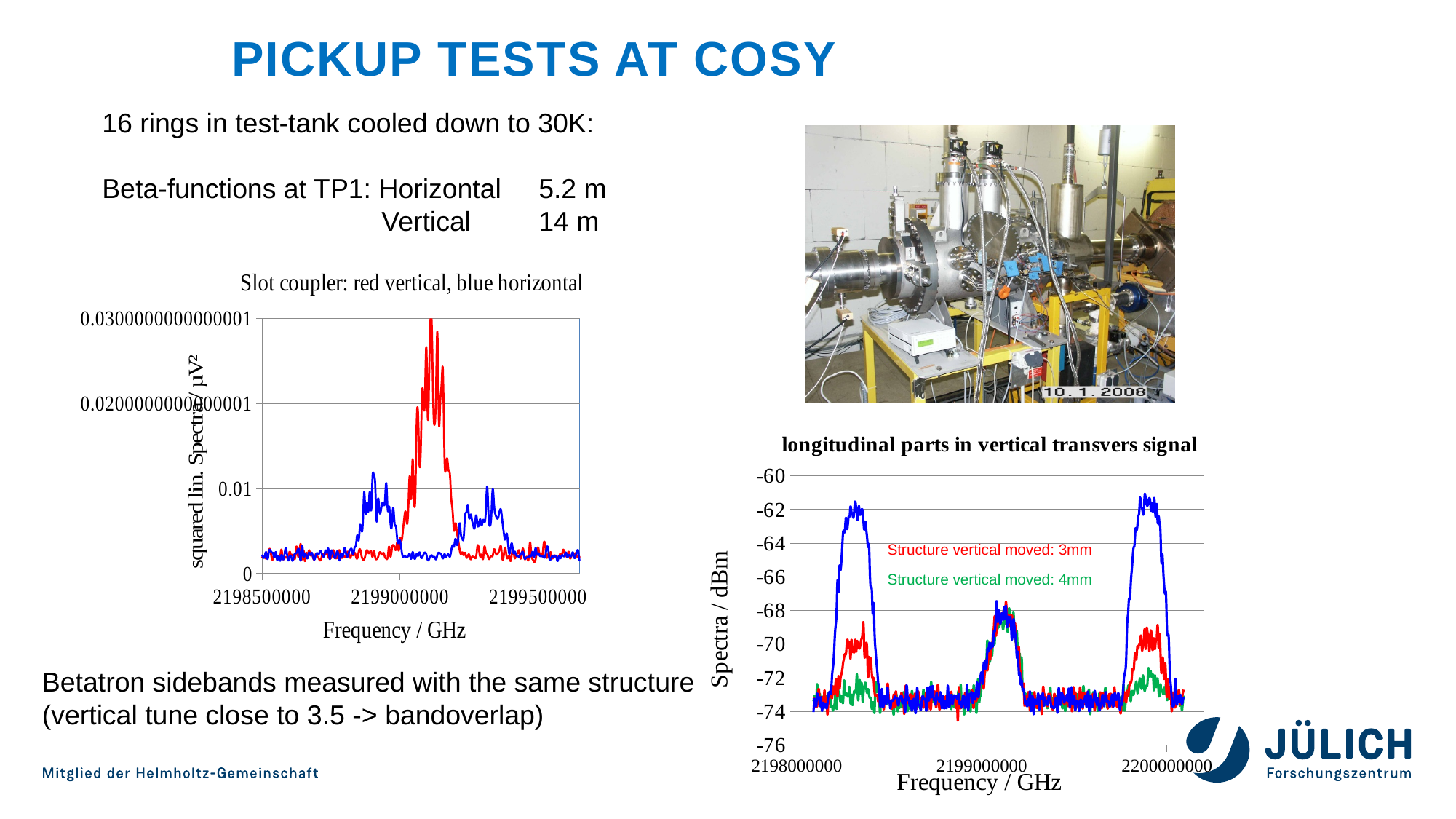
In the 'Slot coupler' chart, is the peak of the red line greater or less than 0.02? greater In the 'longitudinal parts in vertical transvers signal' chart, which line is labelled 'Structure vertical moved: 4mm'? green How many coloured lines are plotted in the 'longitudinal parts in vertical transvers signal' chart? 3 In the 'longitudinal parts in vertical transvers signal' chart, which colour of line has the highest sideband peaks? blue What is the y-axis label of the 'Slot coupler' chart? squared lin. Spectra / µV² In the 'Slot coupler' chart, which colour of line reaches the highest peak? red What kind of chart is the 'longitudinal parts in vertical transvers signal' chart? line chart In the 'Slot coupler' chart, is the highest peak of the blue line greater or less than 0.02? less In the 'longitudinal parts in vertical transvers signal' chart, is the peak of the green line near 2198300000 greater or less than -70? less What kind of chart is the 'Slot coupler: red vertical, blue horizontal' chart? line chart How many coloured lines are plotted in the 'Slot coupler' chart? 2